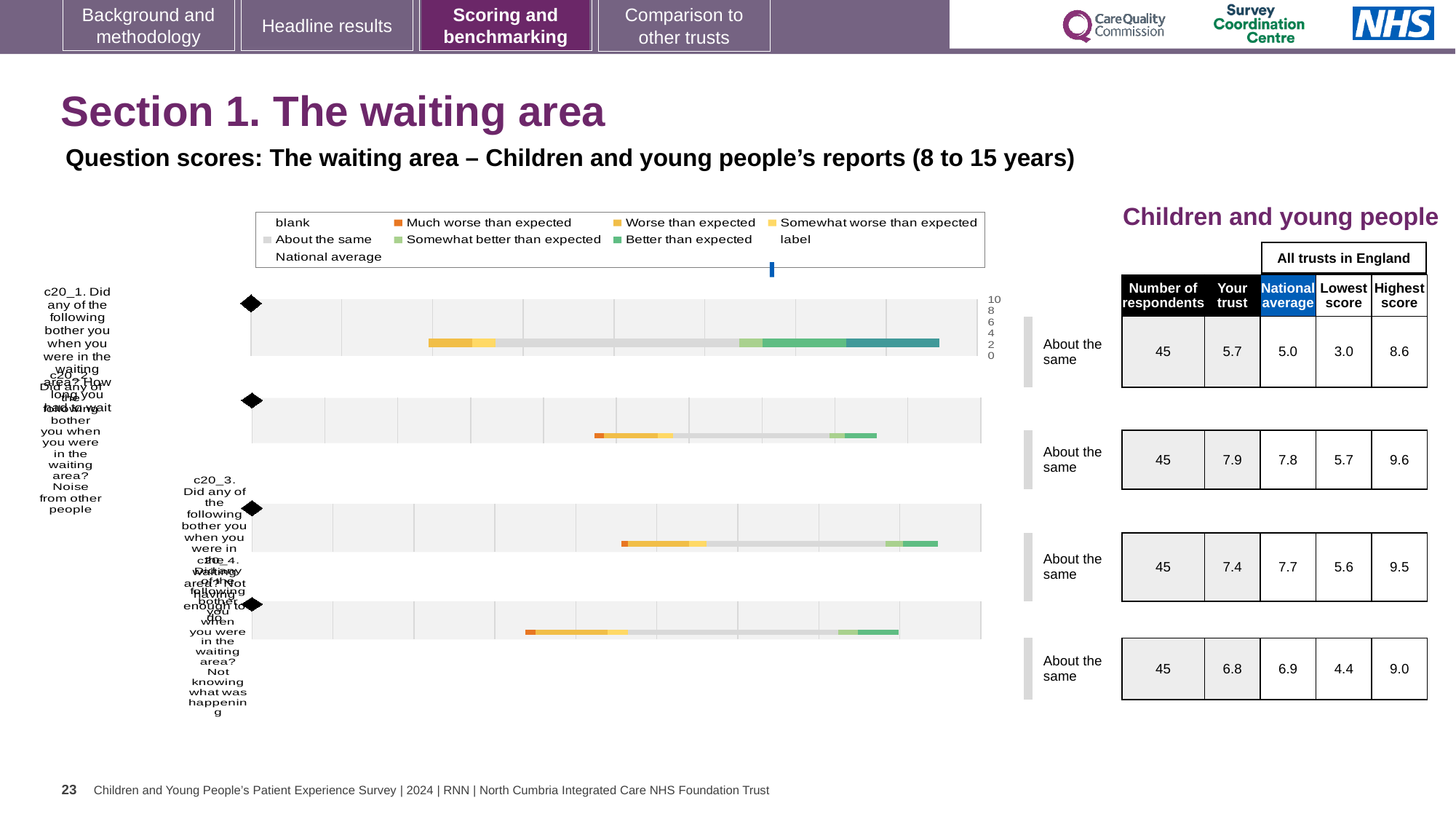
Which question has the lowest 'Your trust' score? c20_1 (how long you had to wait) Which question has the highest 'Your trust' score? c20_2 (noise from other people) What is the highest score across all trusts in England for c20_3 (not having enough to do in the waiting area)? 9.5 What kind of chart is shown on the slide? bar chart How many question bars (c20_1 to c20_4) are plotted in the chart? 4 What is the 'Your trust' score for c20_1 (how long you had to wait in the waiting area)? 5.7 How many respondents answered each of the waiting area questions c20_1 to c20_4? 45 For c20_3, which is larger: the 'Your trust' score or the national average? National average What is the national average score for c20_2 (noise from other people in the waiting area)? 7.8 What is the lowest score across all trusts in England for c20_4 (not knowing what was happening)? 4.4 What is the difference between the highest score (8.6) and the lowest score (3.0) for c20_1? 5.6 What benchmark category is shown for all four waiting area questions? About the same